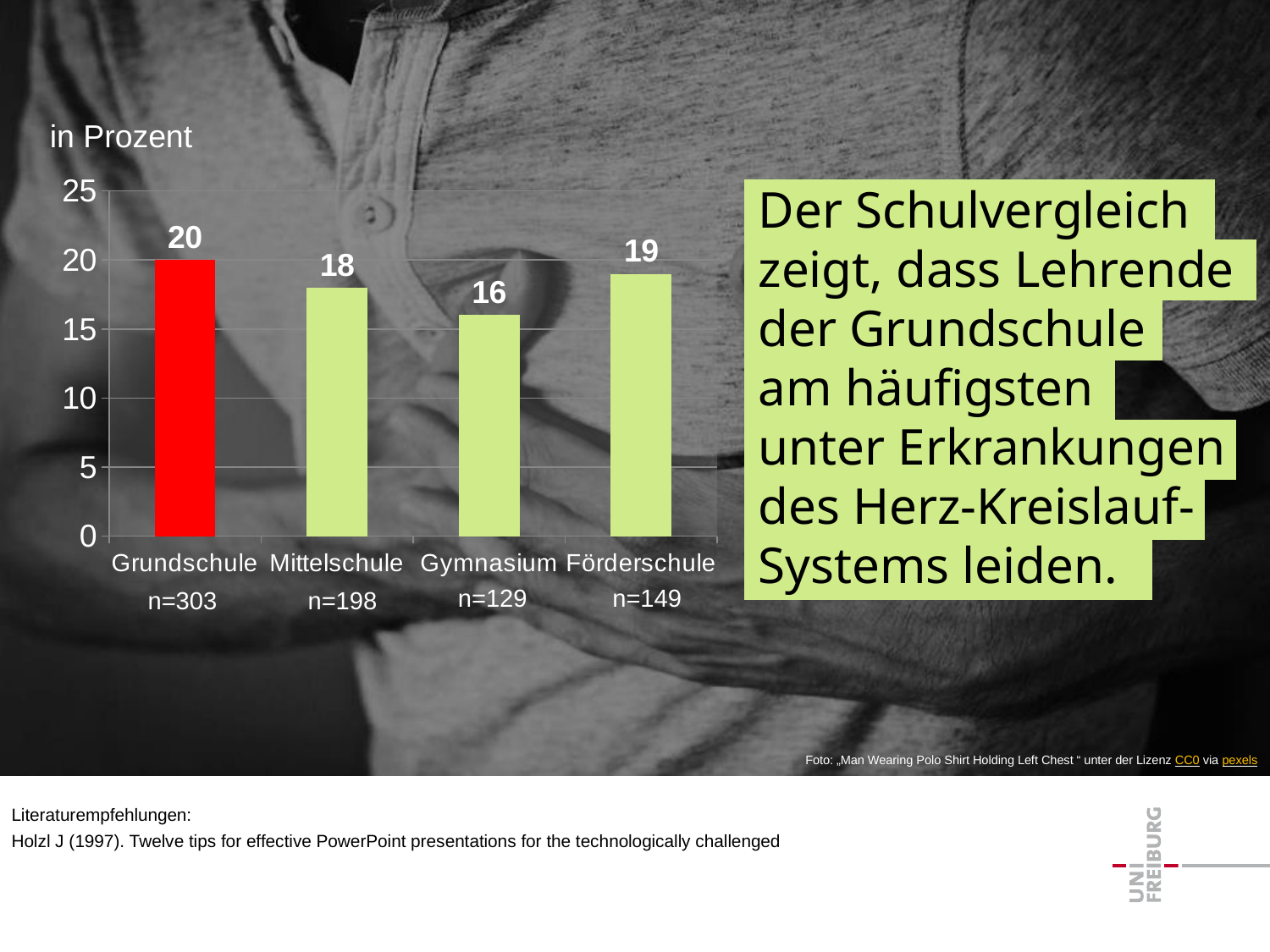
What is the value for Mittelschule? 18 What is the sample size (n) shown for Grundschule? n=303 Which is larger, the value for Mittelschule or the value for Förderschule? Förderschule What kind of chart is shown on the slide? bar chart What is the value for Grundschule? 20 What is the value for Gymnasium? 16 Which bar is coloured red? Grundschule What is the value for Förderschule? 19 Which school type has the lowest value? Gymnasium How many school types are shown in the chart? 4 What is the difference between the values for Grundschule and Gymnasium? 4 Which school type has the highest value? Grundschule